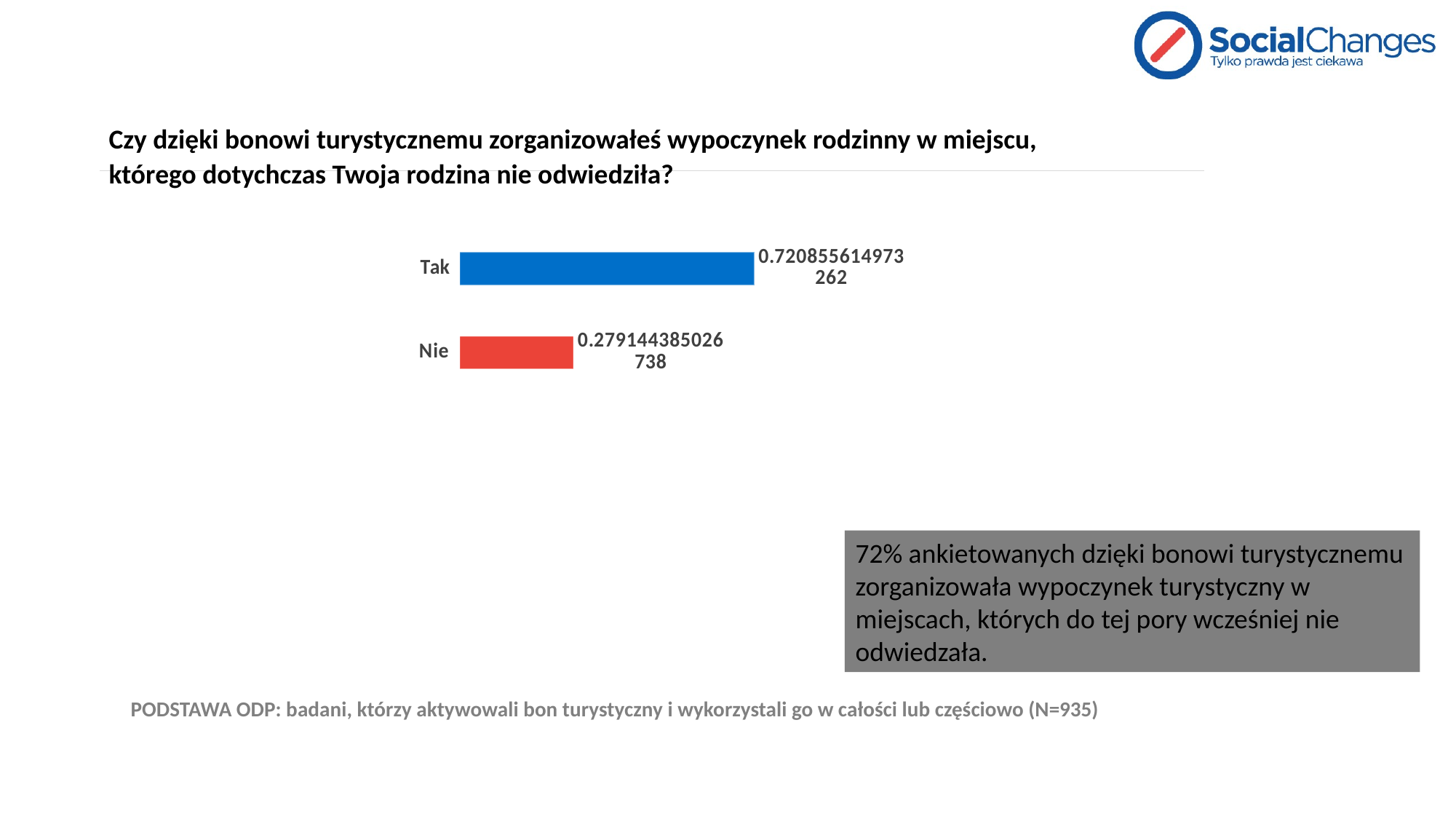
What colour is the bar for "Nie"? Red Which category has the lowest value? Nie What is the value shown for "Tak"? 0.720855614973262 What is the value shown for "Nie"? 0.279144385026738 Which category has the highest value? Tak What is the difference between the values for "Tak" and "Nie"? 0.441711229946524 Which is larger, the value for "Tak" or the value for "Nie"? Tak What colour is the bar for "Tak"? Blue What is the total of the values for "Tak" and "Nie"? 1 What kind of chart is shown on the slide? Bar chart How many categories are shown in the chart? 2